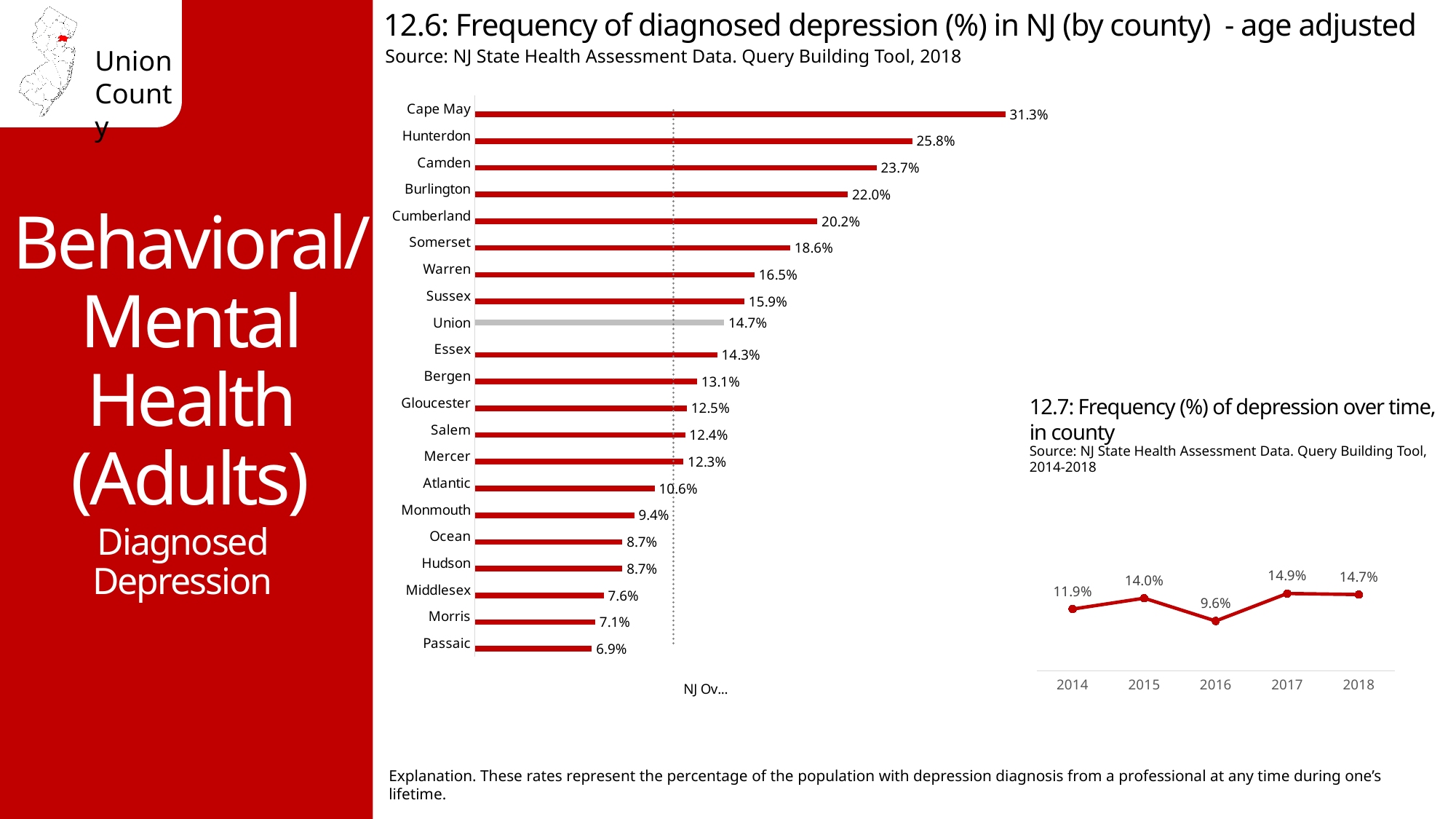
In the chart '12.6: Frequency of diagnosed depression (%) in NJ (by county) - age adjusted', which county has the highest value? Cape May In the chart '12.7: Frequency (%) of depression over time, in county', which year has the highest value? 2017 What kind of chart is '12.6: Frequency of diagnosed depression (%) in NJ (by county) - age adjusted'? Bar chart In the chart '12.6: Frequency of diagnosed depression (%) in NJ (by county) - age adjusted', which county has the lowest value? Passaic In the chart '12.7: Frequency (%) of depression over time, in county', what is the value for 2016? 9.6% In the chart '12.6: Frequency of diagnosed depression (%) in NJ (by county) - age adjusted', which is larger, Somerset or Warren? Somerset In the chart '12.7: Frequency (%) of depression over time, in county', what is the difference between 2017 and 2016? 5.3% What kind of chart is '12.7: Frequency (%) of depression over time, in county'? Line chart In the chart '12.6: Frequency of diagnosed depression (%) in NJ (by county) - age adjusted', what is the value for Union? 14.7% In the chart '12.6: Frequency of diagnosed depression (%) in NJ (by county) - age adjusted', what is the value for Cumberland? 20.2% In the chart '12.6: Frequency of diagnosed depression (%) in NJ (by county) - age adjusted', what is the difference between Cape May and Hunterdon? 5.5% In the chart '12.6: Frequency of diagnosed depression (%) in NJ (by county) - age adjusted', how many counties are shown? 21